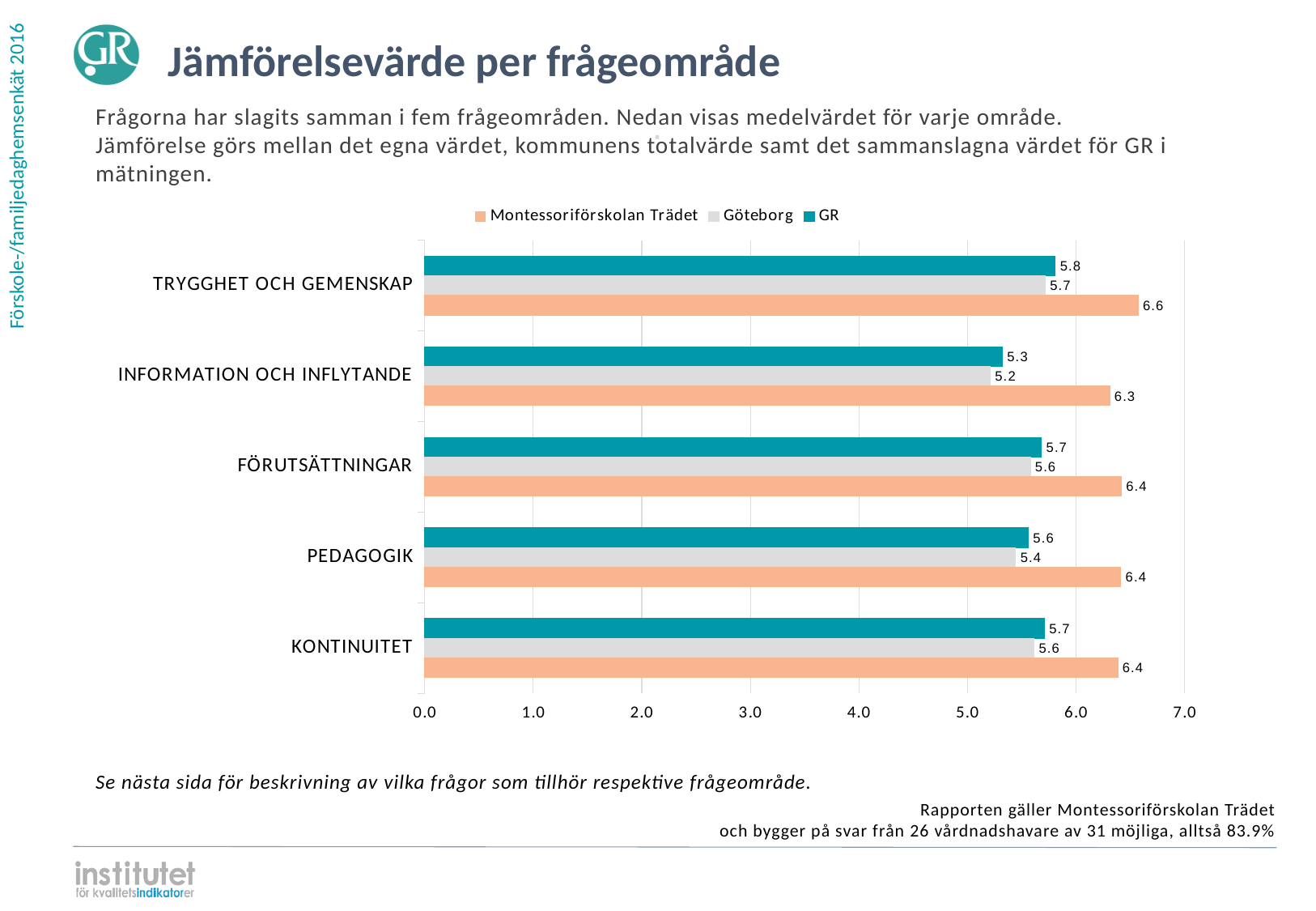
Which is larger in the KONTINUITET category: the value for Göteborg or the value for GR? GR What kind of chart is shown on the slide? bar chart Which series is shown in orange in the legend? Montessoriförskolan Trädet Which category has the lowest value for Göteborg? INFORMATION OCH INFLYTANDE What is the difference between the Montessoriförskolan Trädet value and the GR value in the INFORMATION OCH INFLYTANDE category? 1.0 How many categories are shown on the chart? 5 What is the value for Göteborg in the PEDAGOGIK category? 5.4 Is the value for Montessoriförskolan Trädet in the FÖRUTSÄTTNINGAR category greater or less than 6.0? greater How many series does the legend list? 3 Which category has the highest value for Montessoriförskolan Trädet? TRYGGHET OCH GEMENSKAP What is the value for Montessoriförskolan Trädet in the TRYGGHET OCH GEMENSKAP category? 6.6 What is the value for GR in the INFORMATION OCH INFLYTANDE category? 5.3